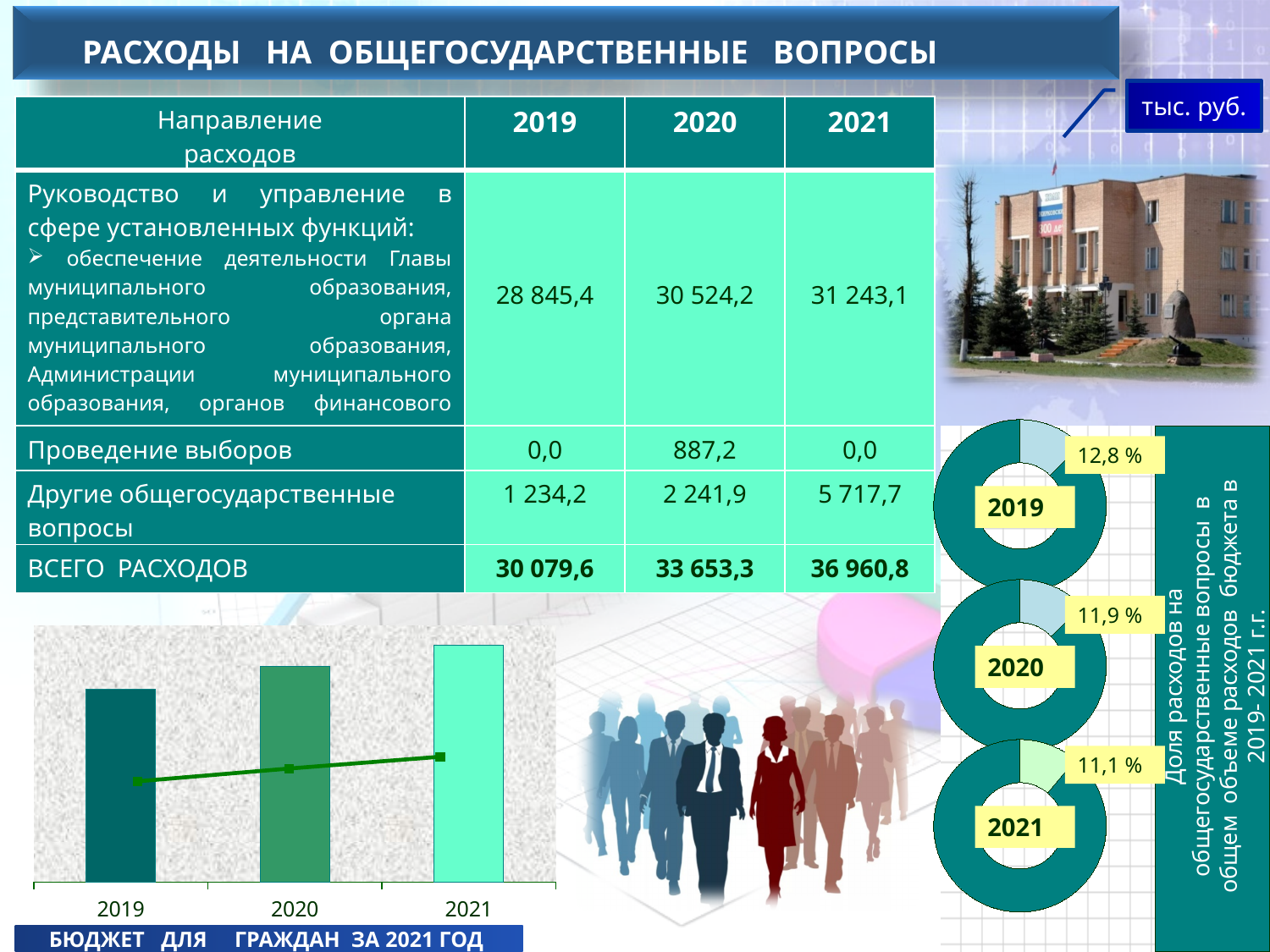
In the donut charts on the right of the slide, what share is shown for 2020? 11,9 % Among the donut charts on the right, which year has the highest share? 2019 In the bar chart at the bottom left, which bar is taller, 2019 or 2020? 2020 How many bars does the bar chart at the bottom left of the slide have? 3 What kind of chart is shown at the bottom left of the slide? bar chart In the bar chart at the bottom left, which year has the tallest bar? 2021 In the donut charts on the right, what is the difference between the 2019 share and the 2021 share? 1,7 % In the bar chart at the bottom left, which year has the shortest bar? 2019 In the bar chart at the bottom left, do the bars rise or fall from 2019 to 2021? rise In the donut charts on the right of the slide, what share is shown for 2021? 11,1 % In the donut charts on the right of the slide, what share is shown for 2019? 12,8 % Among the donut charts on the right, which year has the lowest share? 2021